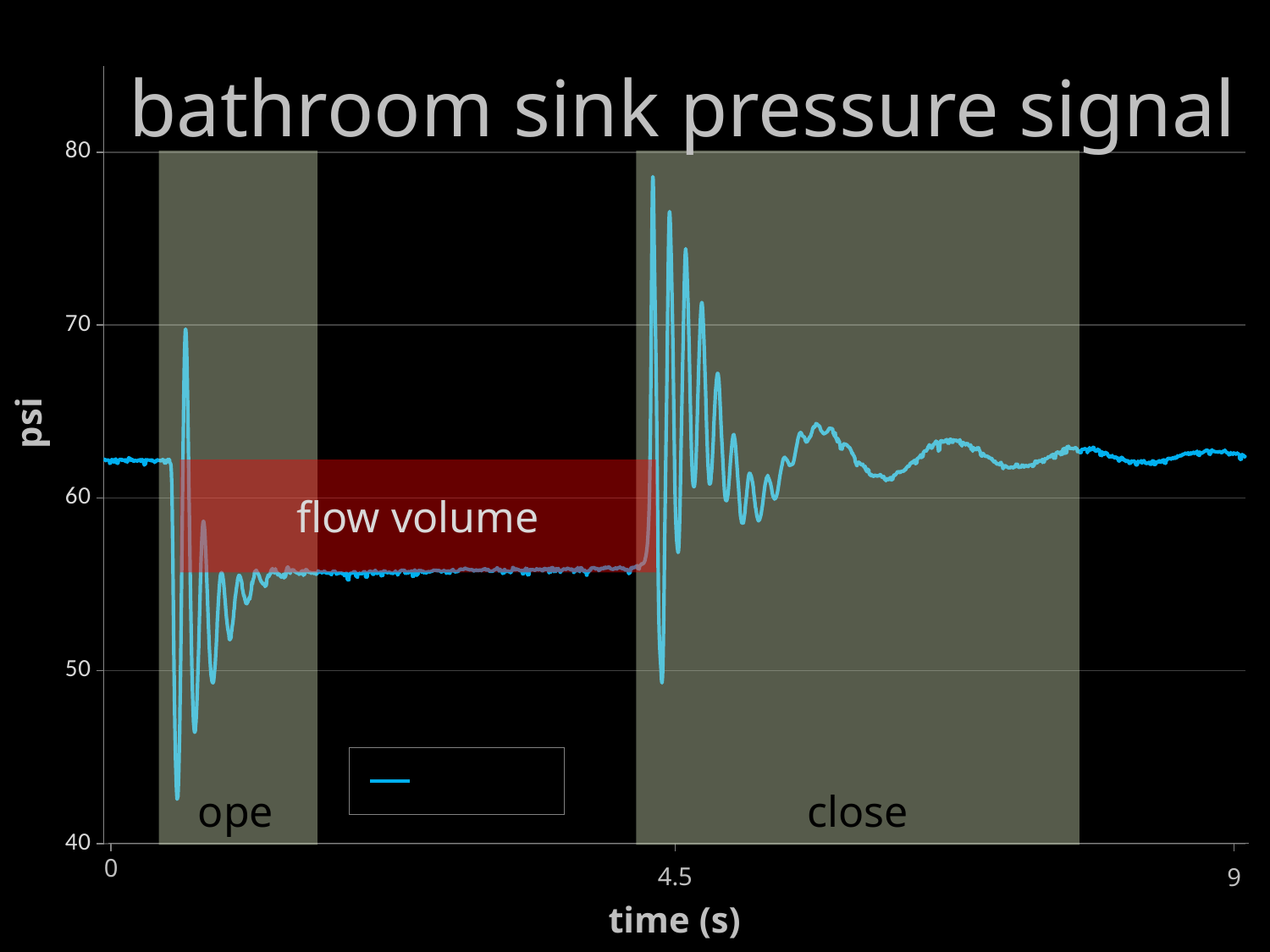
Is the steady pressure level during the 'flow volume' period greater or less than 60 psi? less What is the label of the y axis? psi Which shaded region contains the higher pressure peak, 'ope' or 'close'? close Is the lowest pressure dip in the 'ope' region greater or less than 50 psi? less Is the pressure at time 0 greater or less than 60 psi? greater Which shaded region contains the lower pressure dip, 'ope' or 'close'? ope What is the maximum value shown on the y axis? 80 What is the title of the chart? bathroom sink pressure signal How many series does the legend list? 1 What kind of chart is shown on the slide? line chart